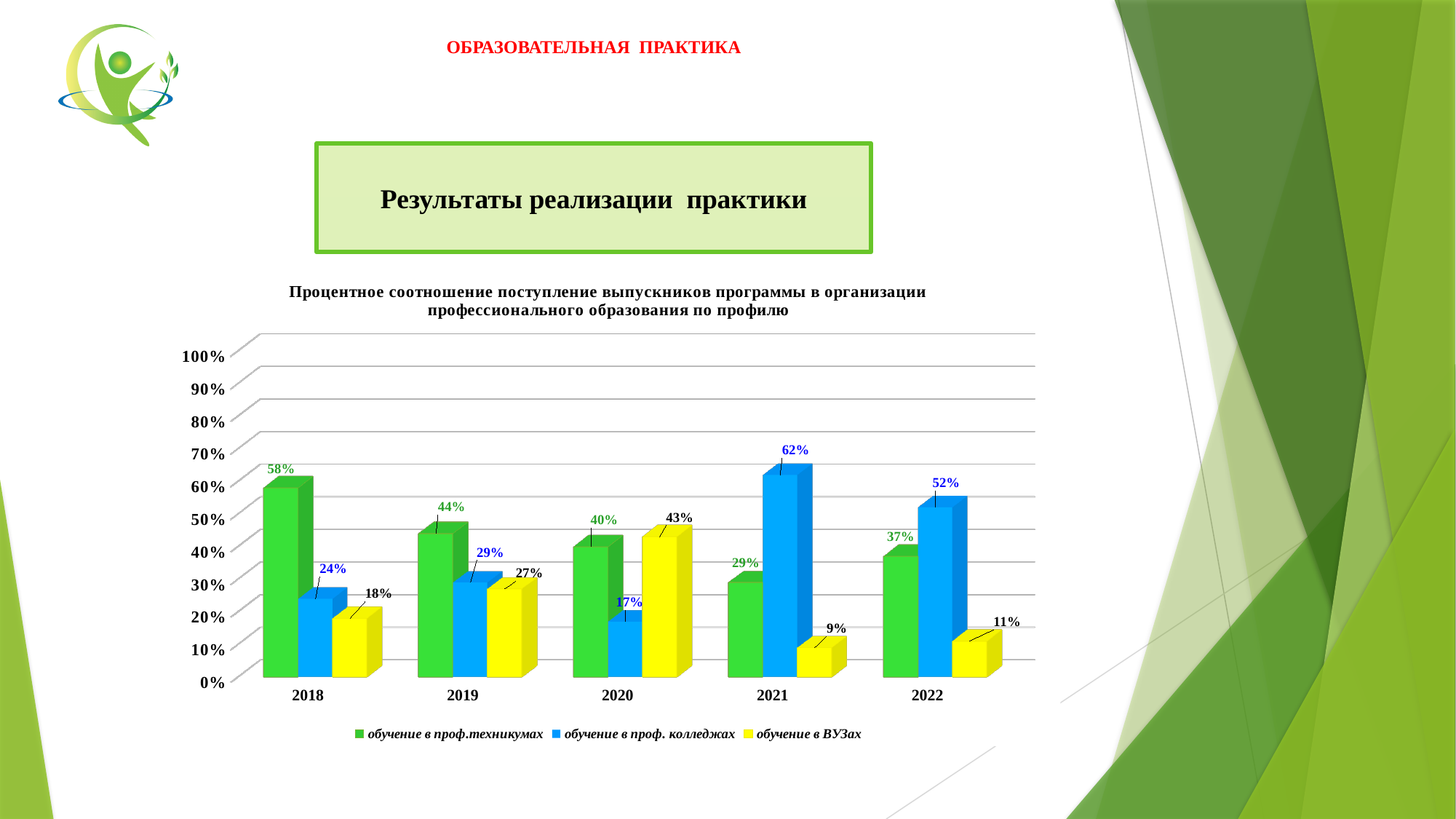
How many series does the legend list? 3 What value is shown for "обучение в ВУЗах" in 2020? 43% In which year is the value for "обучение в проф. колледжах" the highest? 2021 In which year is the value for "обучение в ВУЗах" the lowest? 2021 Which is larger in 2020: "обучение в проф.техникумах" or "обучение в ВУЗах"? обучение в ВУЗах What value is shown for "обучение в проф.техникумах" in 2018? 58% What value is shown for "обучение в проф. колледжах" in 2021? 62% How many years are shown on the x axis? 5 What value is shown for "обучение в ВУЗах" in 2022? 11% Does the value for "обучение в проф.техникумах" rise or fall from 2018 to 2021? fall What kind of chart is shown on the slide? bar chart What is the difference between the "обучение в проф.техникумах" values for 2018 and 2022? 21%